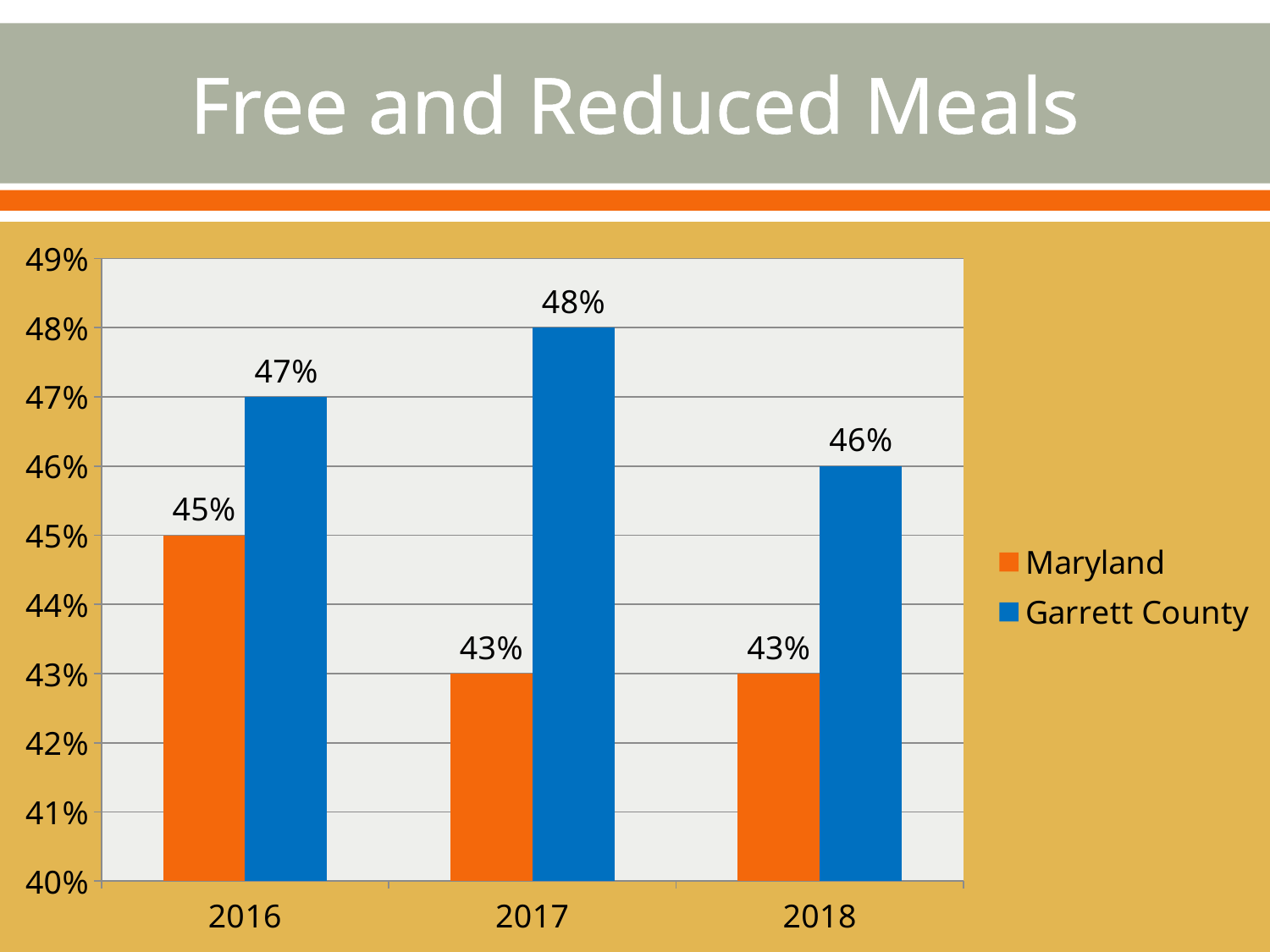
What is the title of the slide? Free and Reduced Meals What is the value for Garrett County in 2017? 48% In which year is the Garrett County value lowest? 2018 How many years are shown on the x axis? 3 What kind of chart is shown on the slide? Bar chart Is the value for Maryland in 2018 greater or less than 44%? less What is the difference between Garrett County and Maryland in 2017? 5% In which year is the Garrett County value highest? 2017 What is the value for Maryland in 2016? 45% What is the value for Garrett County in 2018? 46% Which is larger in 2016, Maryland or Garrett County? Garrett County How many series does the legend list? 2